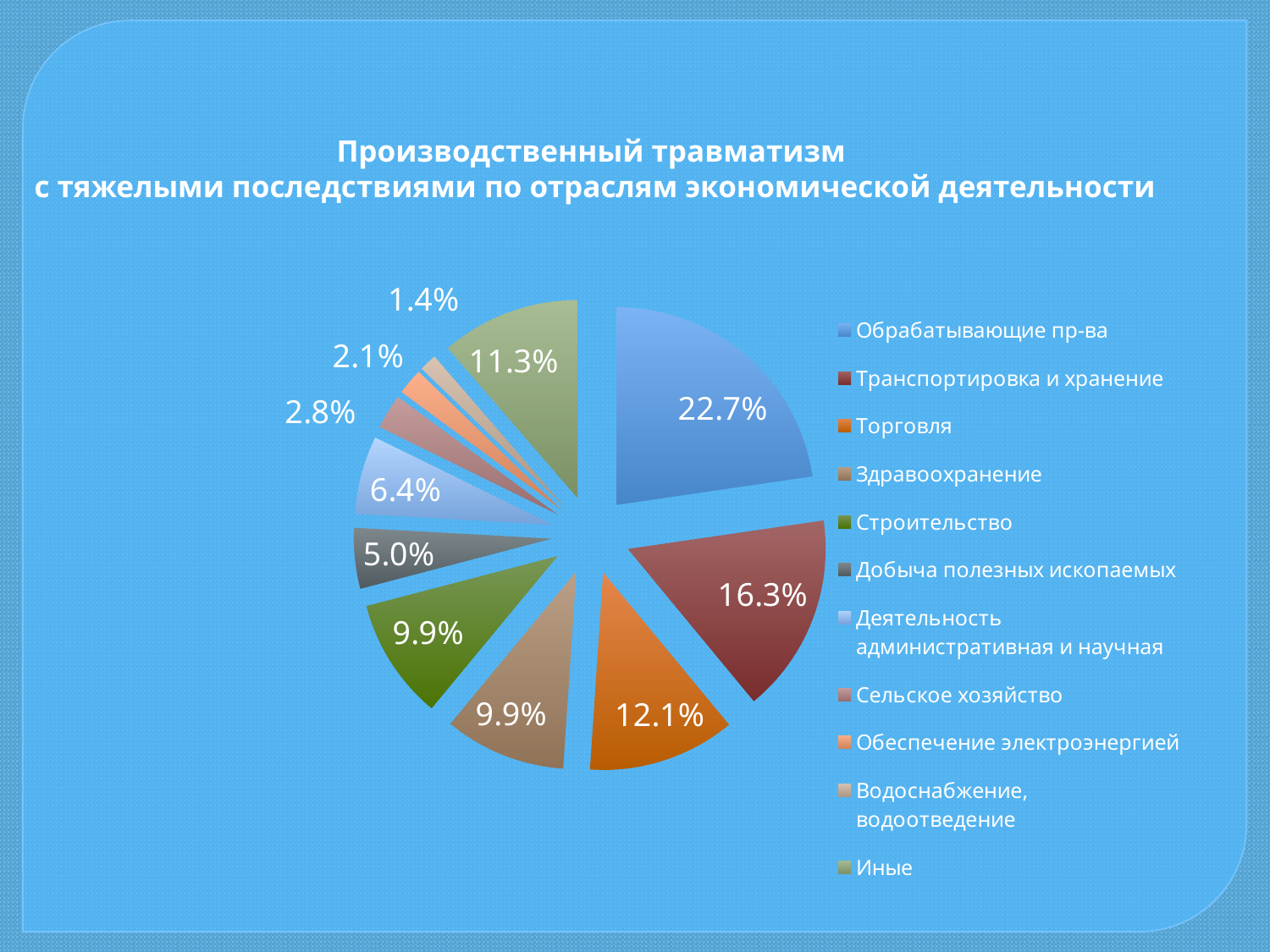
What kind of chart is shown on the slide? pie chart How many categories does the legend list? 11 Which is larger, the value for Деятельность административная и научная or the value for Добыча полезных ископаемых? Деятельность административная и научная What is the value for Торговля? 12.1% What is the title of the chart? Производственный травматизм с тяжелыми последствиями по отраслям экономической деятельности What is the value for Добыча полезных ископаемых? 5.0% What is the difference between the values for Обрабатывающие пр-ва and Транспортировка и хранение? 6.4% What is the value for Иные? 11.3% Which category has the smallest slice of the pie? Водоснабжение, водоотведение Which category has the largest slice of the pie? Обрабатывающие пр-ва What share of the pie does Обрабатывающие пр-ва have? 22.7% What is the value for Транспортировка и хранение? 16.3%